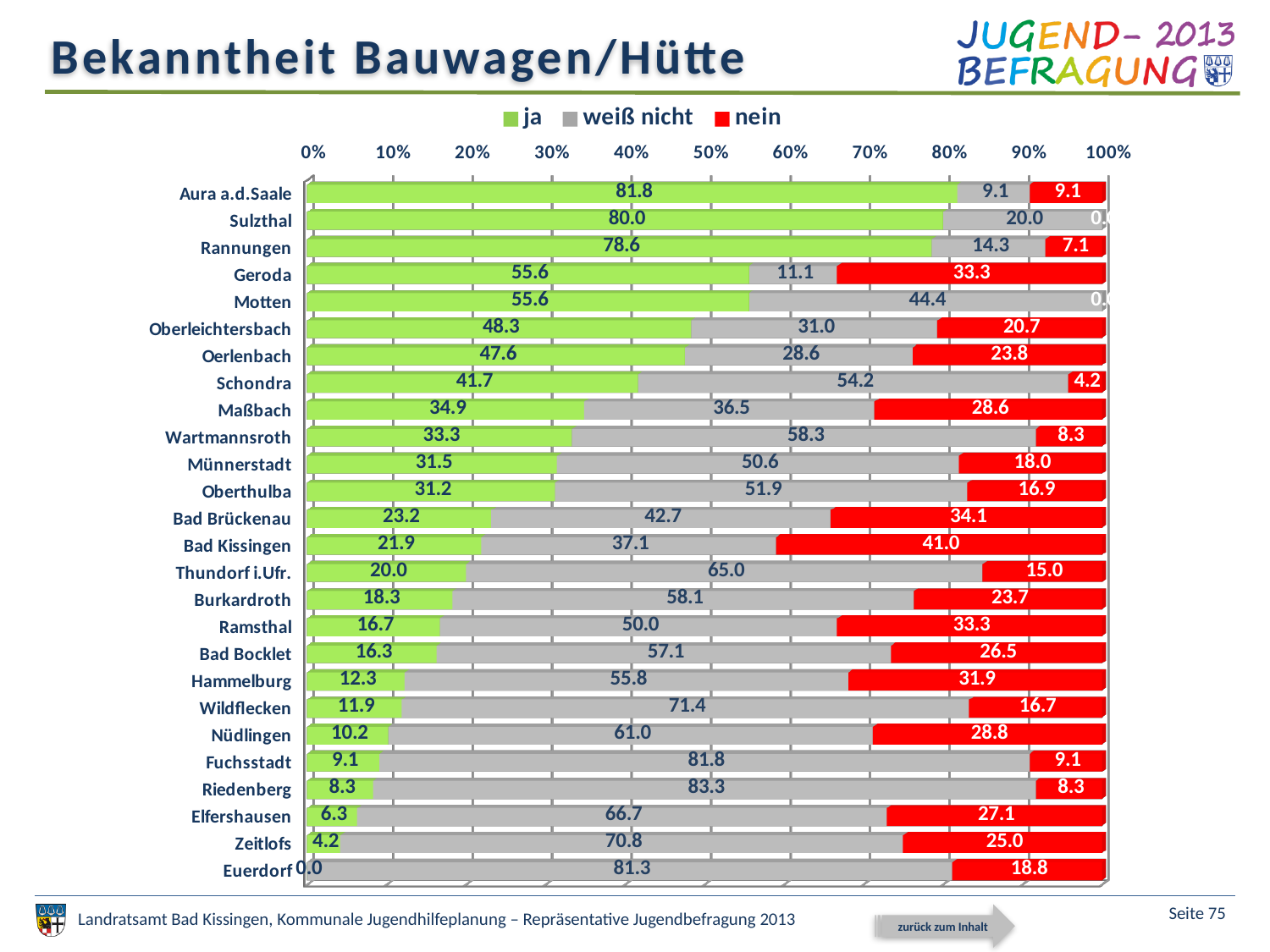
What is the 'nein' value for Bad Kissingen? 41.0 What is the difference between the 'nein' value for Geroda and the 'nein' value for Rannungen? 26.2 Which municipality has the highest 'nein' value? Bad Kissingen How many municipalities are shown in the chart? 26 What is the 'weiß nicht' value for Thundorf i.Ufr.? 65.0 Which colour represents 'nein' in the legend? Red How many series does the legend list? 3 What kind of chart is shown on the slide? Stacked bar chart Which municipality has the lowest 'ja' value? Euerdorf Which municipality has the highest 'ja' value? Aura a.d.Saale Which has the larger 'weiß nicht' value, Schondra or Maßbach? Schondra What is the 'ja' value for Geroda? 55.6